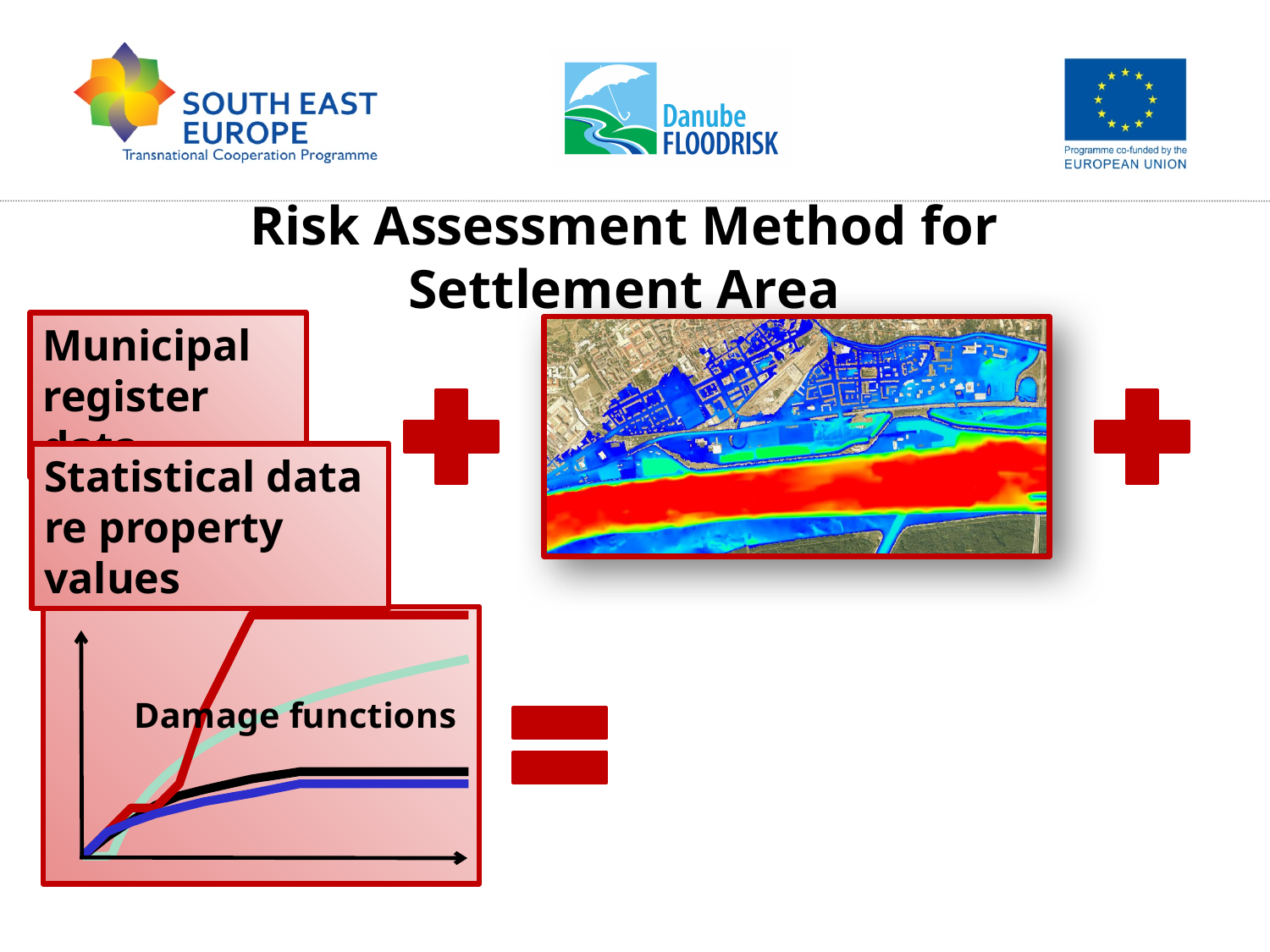
In the "Damage functions" chart, at the right end of the x axis, is the black line or the blue line higher? the black line Does the "Damage functions" chart show a legend? No In the "Damage functions" chart, do the lines rise or fall along the x axis? rise In the "Damage functions" chart, which coloured line is the lowest at the right end of the x axis? the blue line In the "Damage functions" chart, which coloured line reaches the highest value? the red line What is the title printed on the chart at the bottom left of the slide? Damage functions In the "Damage functions" chart, at the right end of the x axis, is the light green line or the black line higher? the light green line What kind of chart is the "Damage functions" chart on the slide? line chart